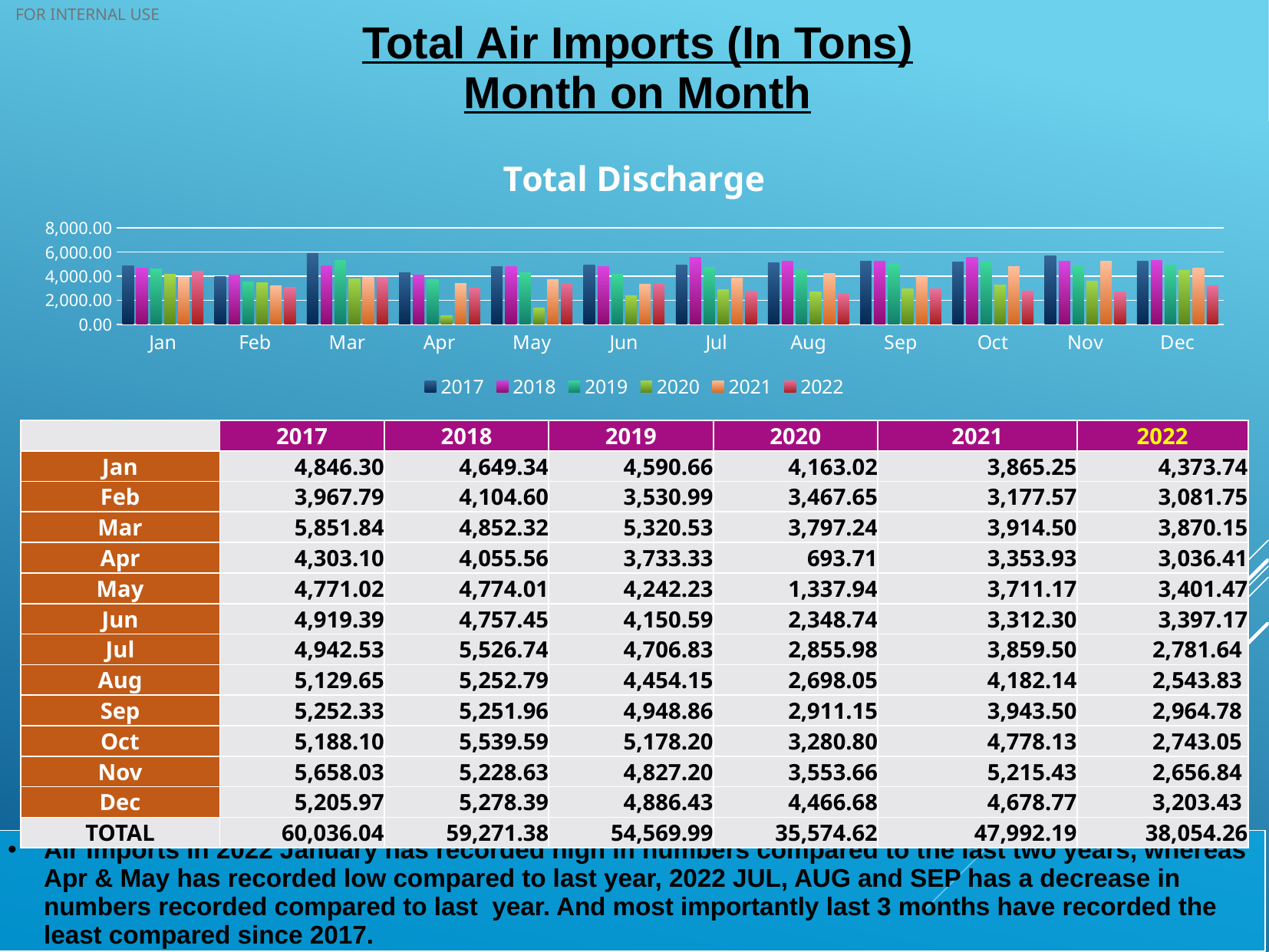
What is the Total Discharge value for April 2020? 693.71 How many months are shown along the x axis of the Total Discharge chart? 12 Is the value for May 2020 greater or less than 2,000.00? less What is the Total Discharge value for November 2021? 5,215.43 Which year has the highest Total Discharge value in March? 2017 Which is larger, the July value for 2018 or for 2019? 2018 Which year has the lowest Total Discharge value in April? 2020 How many series does the legend of the Total Discharge chart list? 6 What is the difference between the January values for 2017 and 2022? 472.56 What is the title of the chart? Total Discharge Do the 2020 values rise or fall from April to July? rise What type of chart is shown on the slide? bar chart